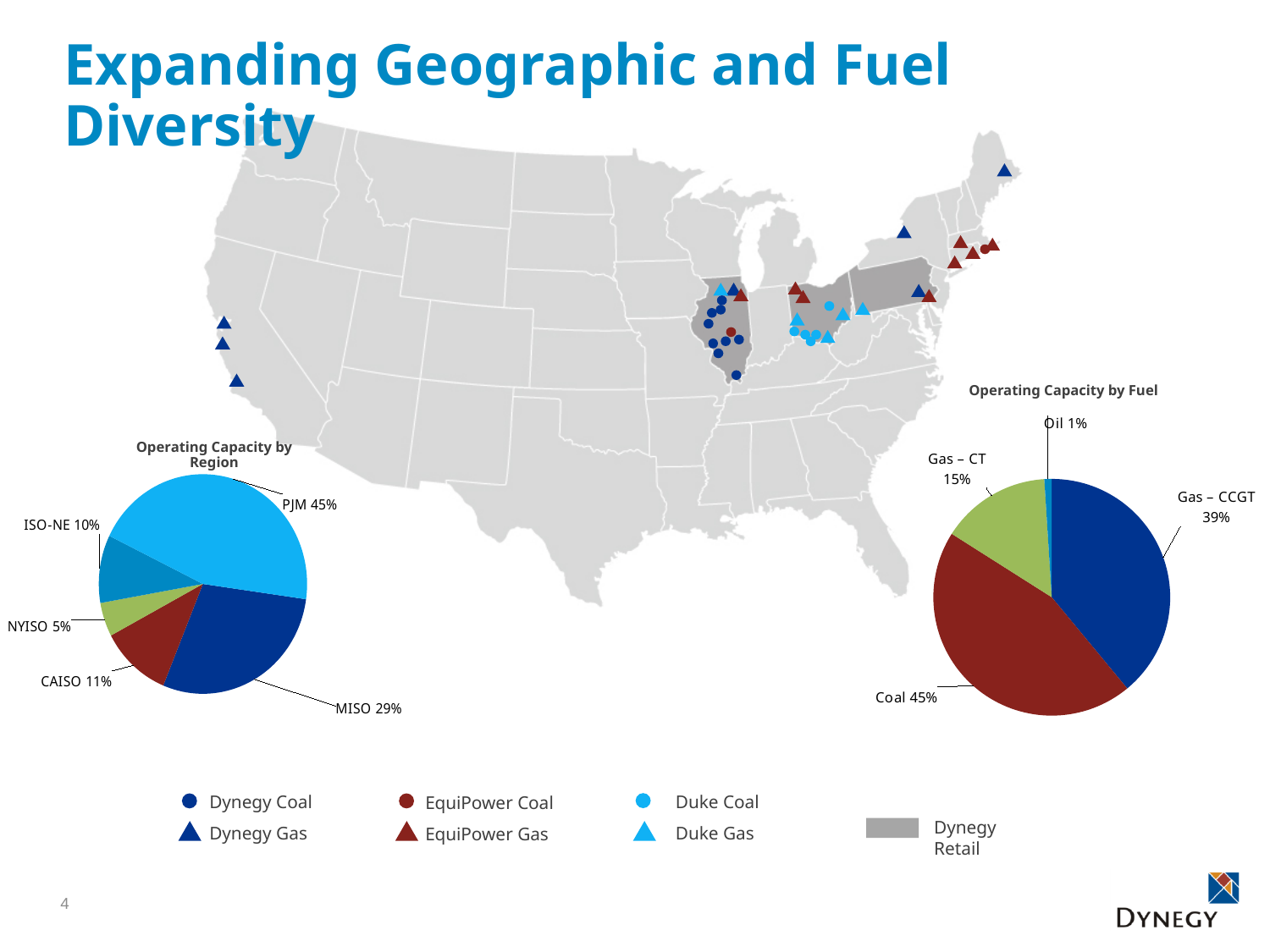
In the Operating Capacity by Region chart, how many regions are shown? 5 In the Operating Capacity by Region chart, what share does PJM have? 45% In the Operating Capacity by Region chart, which region has the largest share? PJM In the Operating Capacity by Region chart, what share does MISO have? 29% In the Operating Capacity by Region chart, what is the difference between the PJM and MISO shares? 16% In the Operating Capacity by Fuel chart, what share does Gas – CT have? 15% What type of chart is the Operating Capacity by Fuel chart? Pie chart In the Operating Capacity by Fuel chart, which is larger, Coal or Gas – CCGT? Coal In the Operating Capacity by Fuel chart, what share does Coal have? 45% In the Operating Capacity by Fuel chart, which fuel has the smallest share? Oil In the Operating Capacity by Fuel chart, how many fuel categories are shown? 4 In the Operating Capacity by Region chart, which region has the smallest share? NYISO